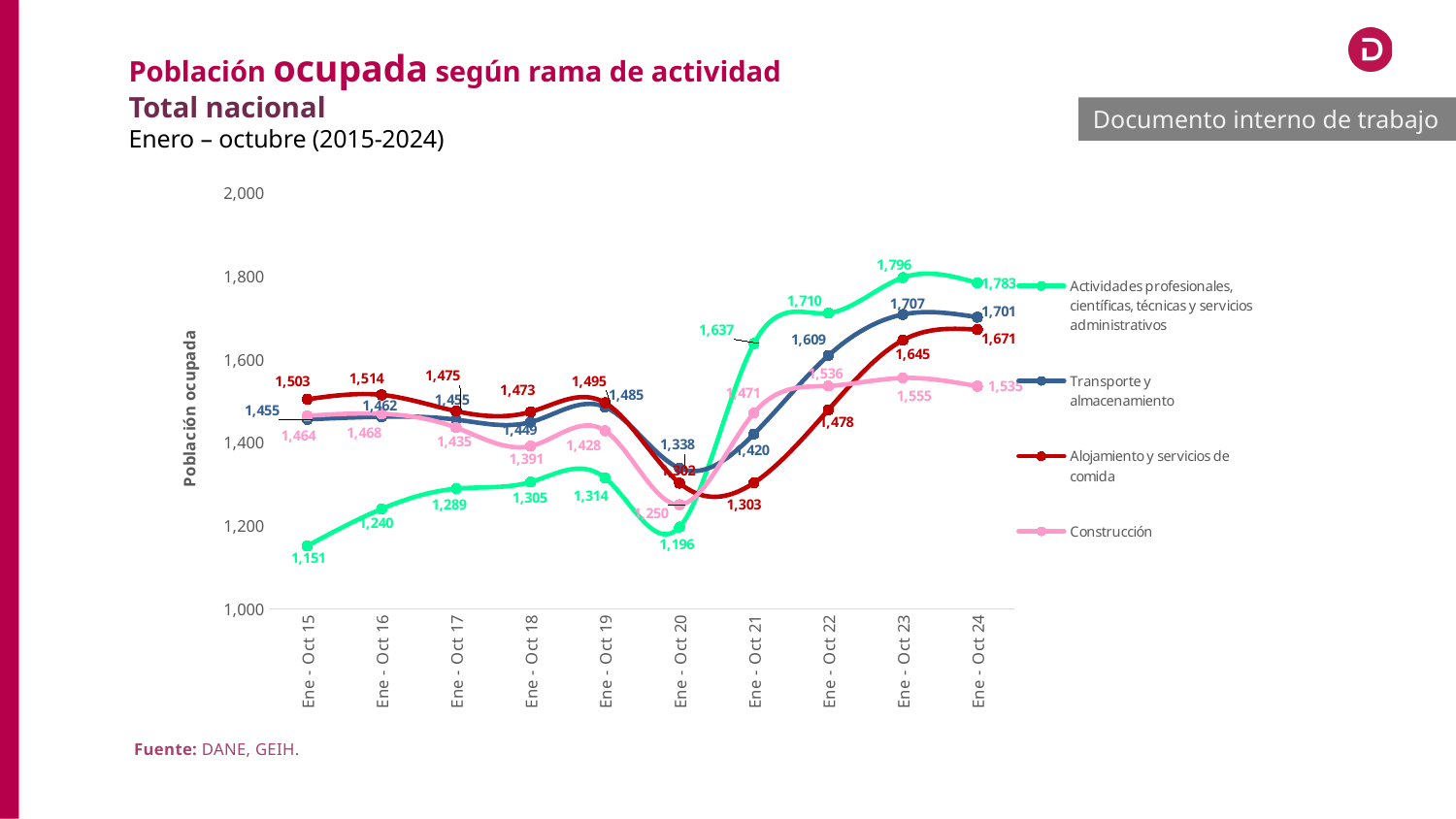
In which period does Actividades profesionales, científicas, técnicas y servicios administrativos reach its highest value? Ene - Oct 23 In which period does Transporte y almacenamiento have its lowest value? Ene - Oct 20 How many series does the legend list? 4 Is the value for Alojamiento y servicios de comida in Ene - Oct 21 greater or less than 1,400? less What is the value for Transporte y almacenamiento in Ene - Oct 23? 1,707 How many periods are shown on the x axis? 10 What type of chart is shown on the slide? Line chart What is the value for Actividades profesionales, científicas, técnicas y servicios administrativos in Ene - Oct 15? 1,151 What is the value for Construcción in Ene - Oct 22? 1,536 What is the value for Alojamiento y servicios de comida in Ene - Oct 24? 1,671 Which series has the higher value in Ene - Oct 24, Transporte y almacenamiento or Construcción? Transporte y almacenamiento What is the difference between the Actividades profesionales value in Ene - Oct 23 and in Ene - Oct 15? 645